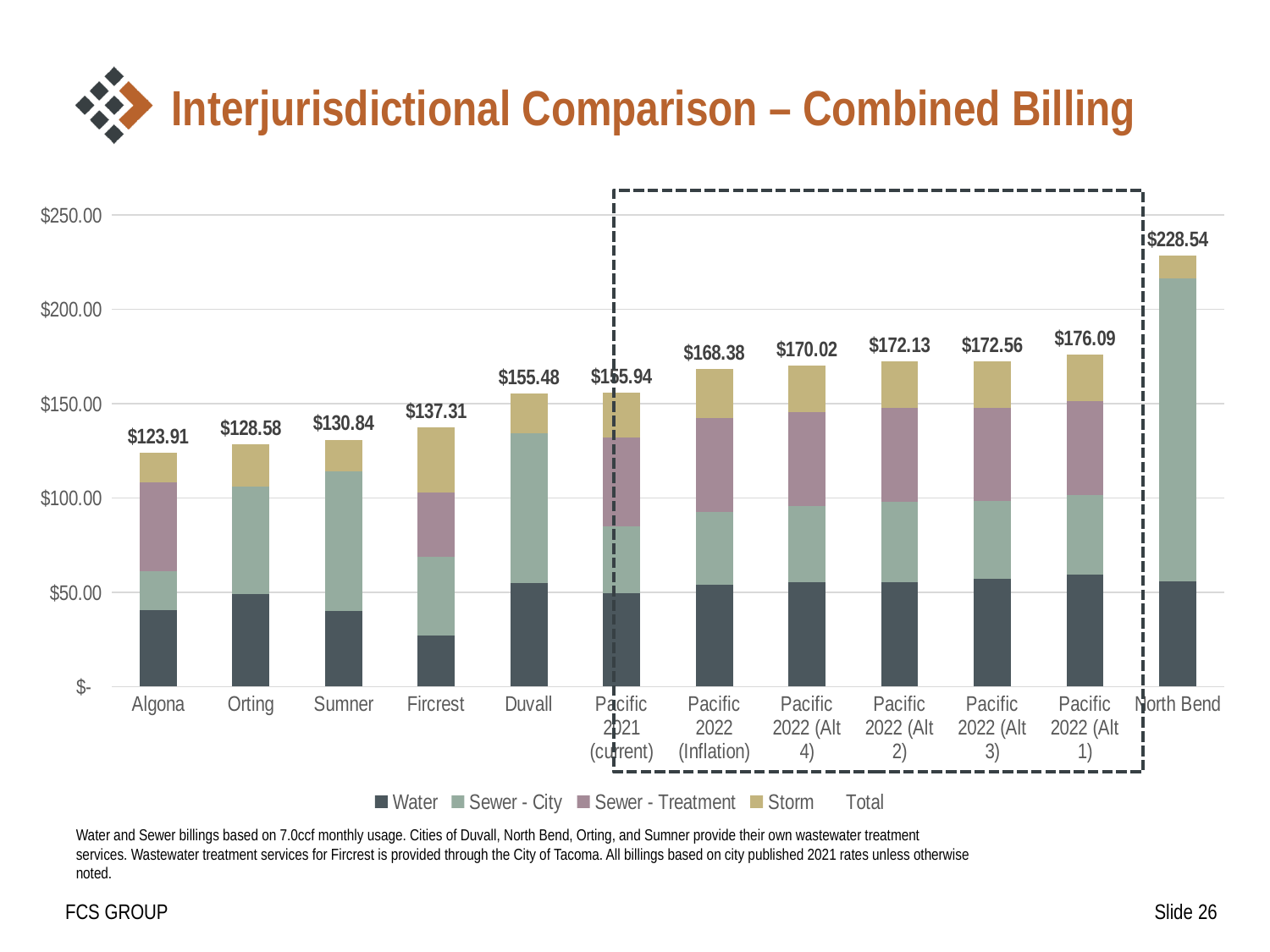
What is the total combined billing shown for Pacific 2022 (Alt 1)? $176.09 Which has a larger total combined billing, Duvall or Fircrest? Duvall Is the Water portion of the Algona bar greater or less than $50.00? less Do the total combined billing values rise or fall from Algona to North Bend along the x axis? Rise Is the Sewer - City portion of the North Bend bar greater or less than $100.00? greater What is the difference between the total for North Bend and the total for Pacific 2021 (current)? $72.60 Which city has the highest total combined billing? North Bend How many entries does the legend list? 5 What is the total combined billing shown for Algona? $123.91 What kind of chart is shown on the slide? Stacked bar chart Which city has the lowest total combined billing? Algona How many cities or scenarios are shown on the x axis? 12